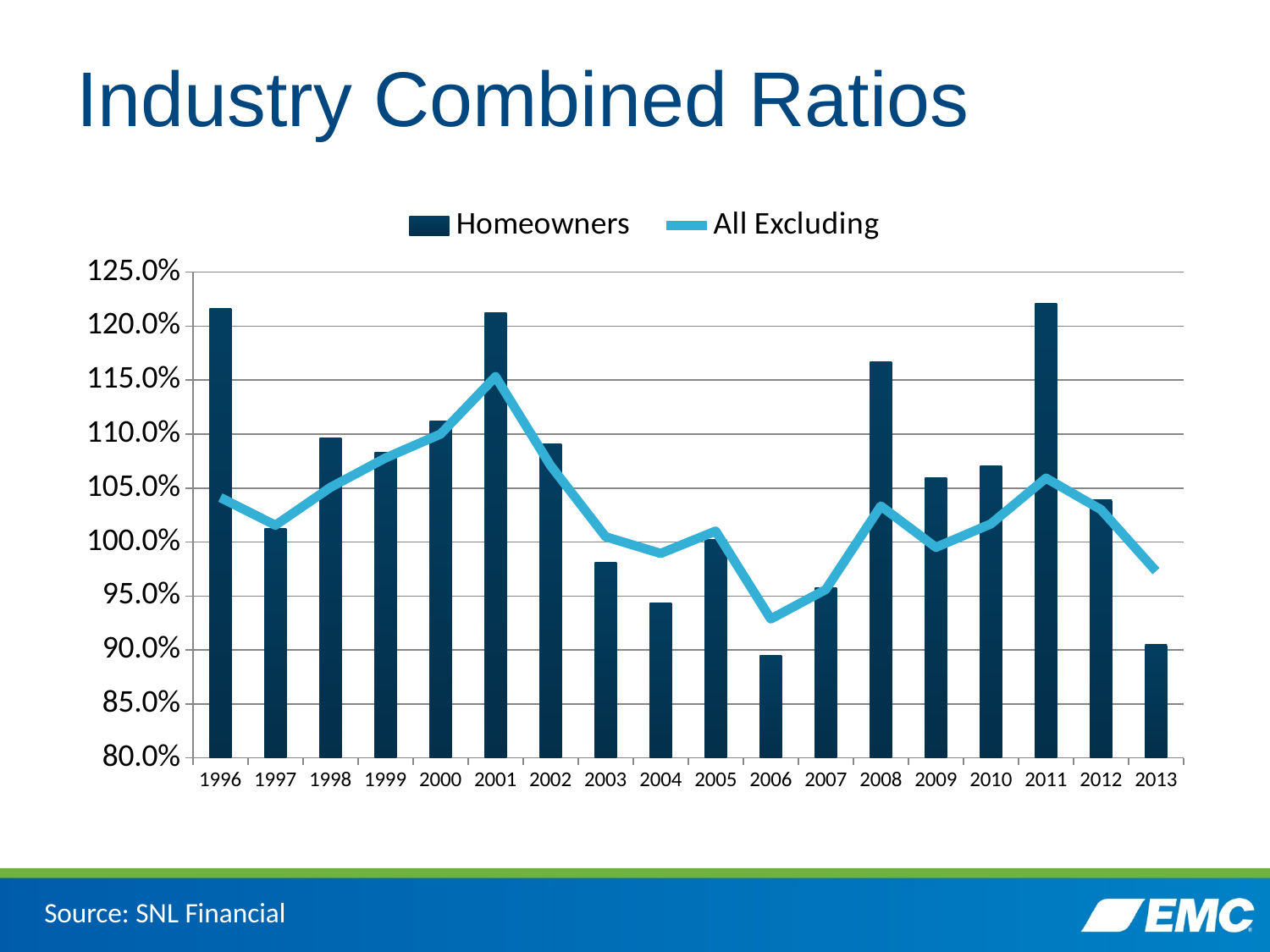
What kind of chart is this? Combination bar and line chart Is the Homeowners value for 2012 greater or less than 100.0%? greater In which year does the All Excluding line reach its lowest value? 2006 Which series is drawn as a line? All Excluding Do the Homeowners values rise or fall from 2001 to 2006? fall Which is larger, the Homeowners value for 2008 or for 2009? 2008 How many series does the legend list? 2 Is the Homeowners value for 2003 greater or less than 100.0%? less In which year does the All Excluding line reach its highest value? 2001 Which is larger, the Homeowners value for 2006 or for 2007? 2007 How many years are shown on the x axis? 18 Is the Homeowners value for 2008 greater or less than 115.0%? greater